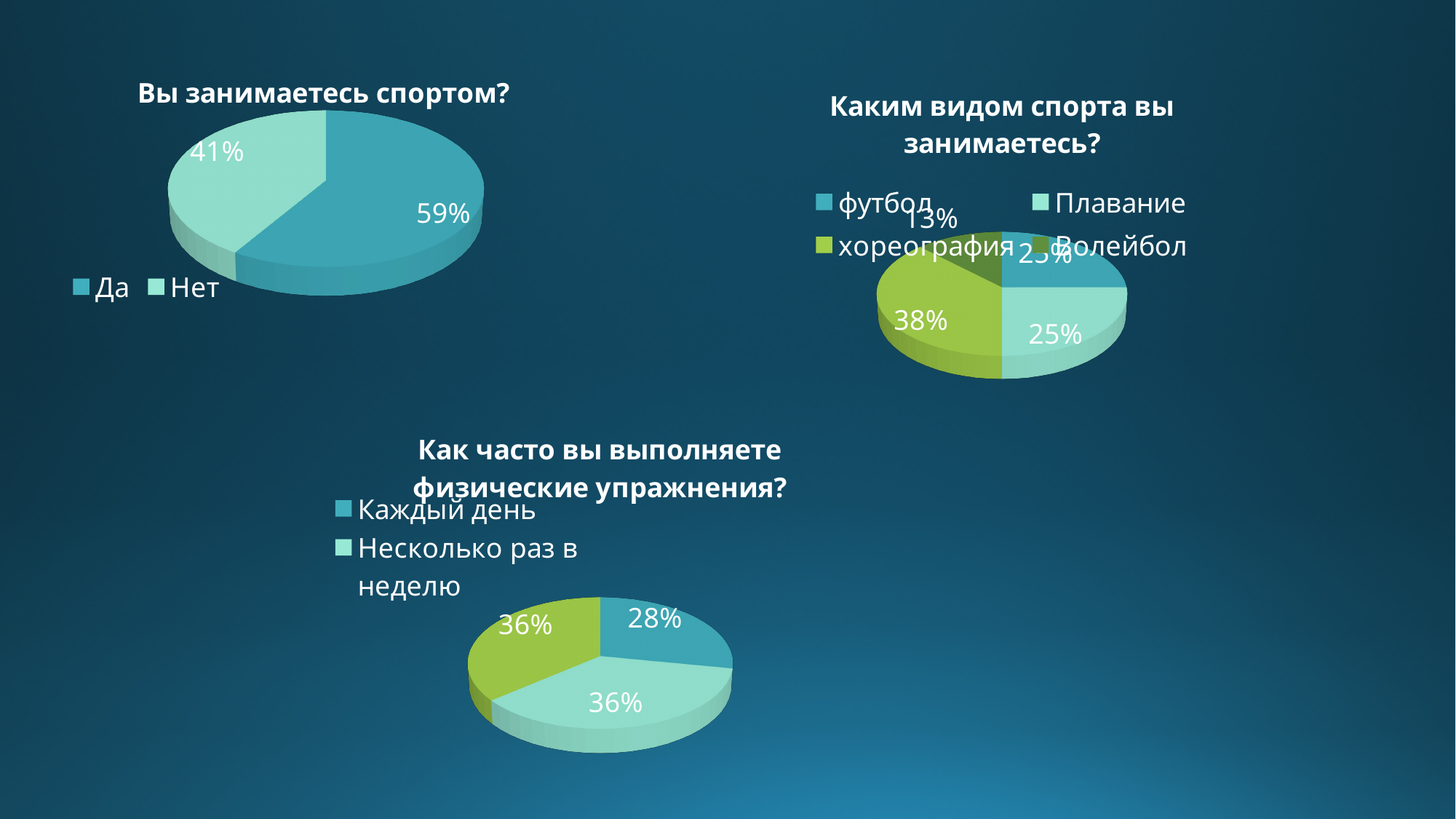
How many pie charts are shown on the slide? 3 In the chart titled "Каким видом спорта вы занимаетесь?", which sport has the smallest share? Волейбол In the chart titled "Каким видом спорта вы занимаетесь?", what percentage is shown for "Волейбол"? 13% What kind of chart is the one titled "Вы занимаетесь спортом?"? Pie chart In the chart titled "Вы занимаетесь спортом?", what percentage is shown for "Да"? 59% How many entries does the legend of the chart titled "Каким видом спорта вы занимаетесь?" list? 4 In the chart titled "Как часто вы выполняете физические упражнения?", what percentage is shown for "Каждый день"? 28% In the chart titled "Вы занимаетесь спортом?", what is the difference in percentage points between "Да" and "Нет"? 18% In the chart titled "Вы занимаетесь спортом?", what percentage is shown for "Нет"? 41% In the chart titled "Каким видом спорта вы занимаетесь?", which sport has the largest share? хореография In the chart titled "Как часто вы выполняете физические упражнения?", what percentage is shown for "Несколько раз в неделю"? 36% In the chart titled "Каким видом спорта вы занимаетесь?", what percentage is shown for "хореография"? 38%